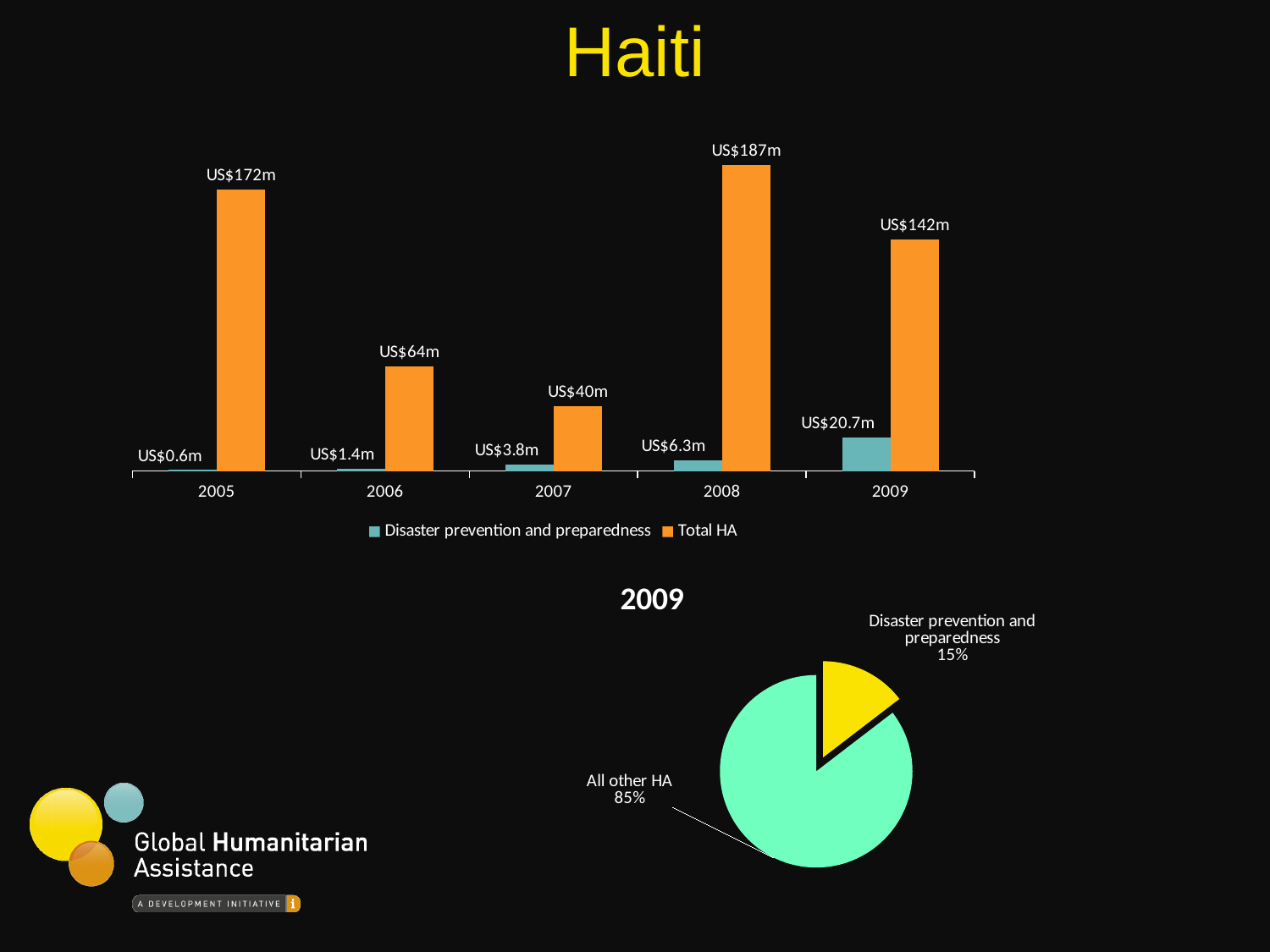
In the bar chart, is Total HA larger in 2007 or in 2009? 2009 In the bar chart, which year has the lowest Disaster prevention and preparedness value? 2005 In the bar chart, does the Disaster prevention and preparedness value rise or fall from 2005 to 2009? Rise How many years are shown on the x axis of the bar chart? 5 In the bar chart, which year has the highest Total HA? 2008 In the 2009 pie chart, what share is All other HA? 85% In the bar chart, what is the difference between Total HA in 2005 and Total HA in 2006? US$108m In the bar chart, what is the Disaster prevention and preparedness value for 2009? US$20.7m In the bar chart, what is the Total HA value for 2008? US$187m In the 2009 pie chart, what share is Disaster prevention and preparedness? 15% What kind of chart is the upper chart on the slide? Bar chart How many series does the legend of the bar chart list? 2